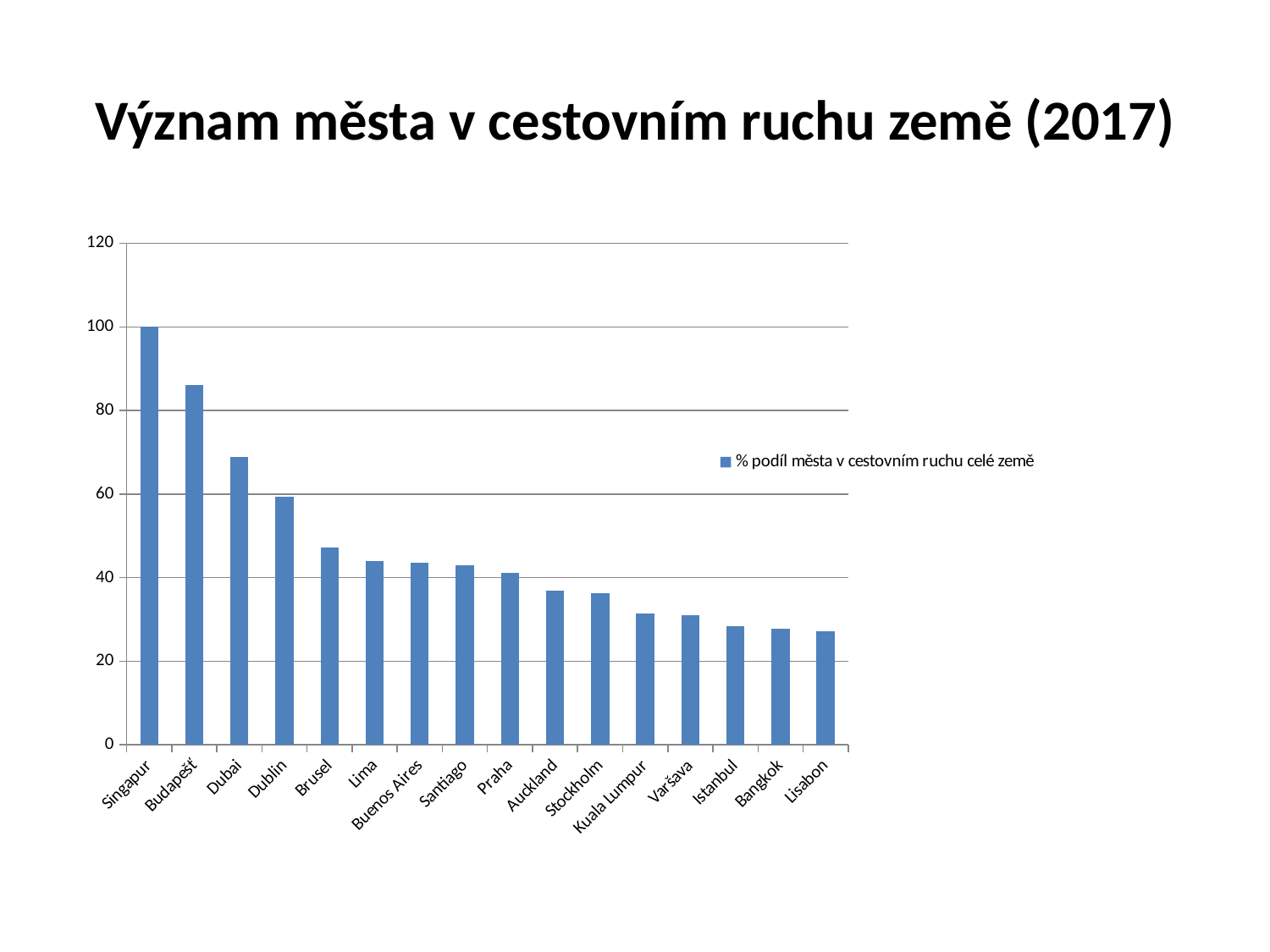
Is the value for Lisabon greater or less than 40? less Do the values rise or fall from left to right along the x axis? fall How many cities are shown on the x axis of the chart? 16 What is the title of the slide? Význam města v cestovním ruchu země (2017) How many series does the chart's legend list? 1 What is the value for Singapur? 100 What kind of chart is shown on the slide? bar chart Is the value for Auckland greater or less than 40? less Which city has the highest value in the chart? Singapur Is the value for Budapešť greater or less than 80? greater Which has the larger value, Dubai or Dublin? Dubai